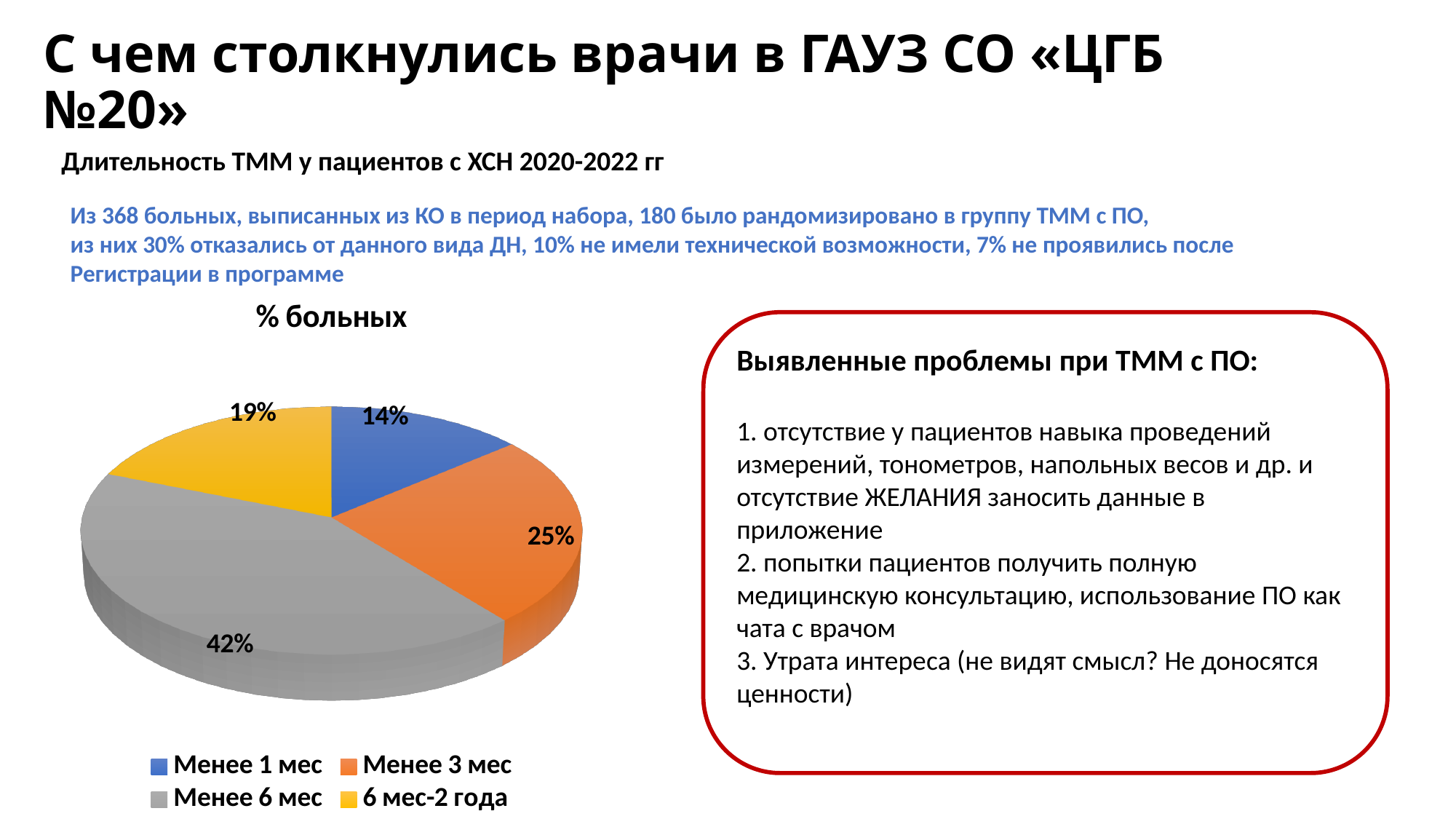
What percentage of patients is shown for "6 мес-2 года"? 19% Which colour represents "Менее 6 мес" in the pie chart? gray What percentage of patients is shown for "Менее 1 мес"? 14% What is the difference between the shares for "Менее 6 мес" and "Менее 3 мес"? 17% What is the title of the pie chart? % больных Which is larger: the share for "6 мес-2 года" or the share for "Менее 1 мес"? 6 мес-2 года What percentage of patients is shown for "Менее 6 мес"? 42% What kind of chart is shown on the slide? pie chart What percentage of patients is shown for "Менее 3 мес"? 25% Which category has the largest share of the pie? Менее 6 мес Which category has the smallest share of the pie? Менее 1 мес How many categories does the pie chart have? 4